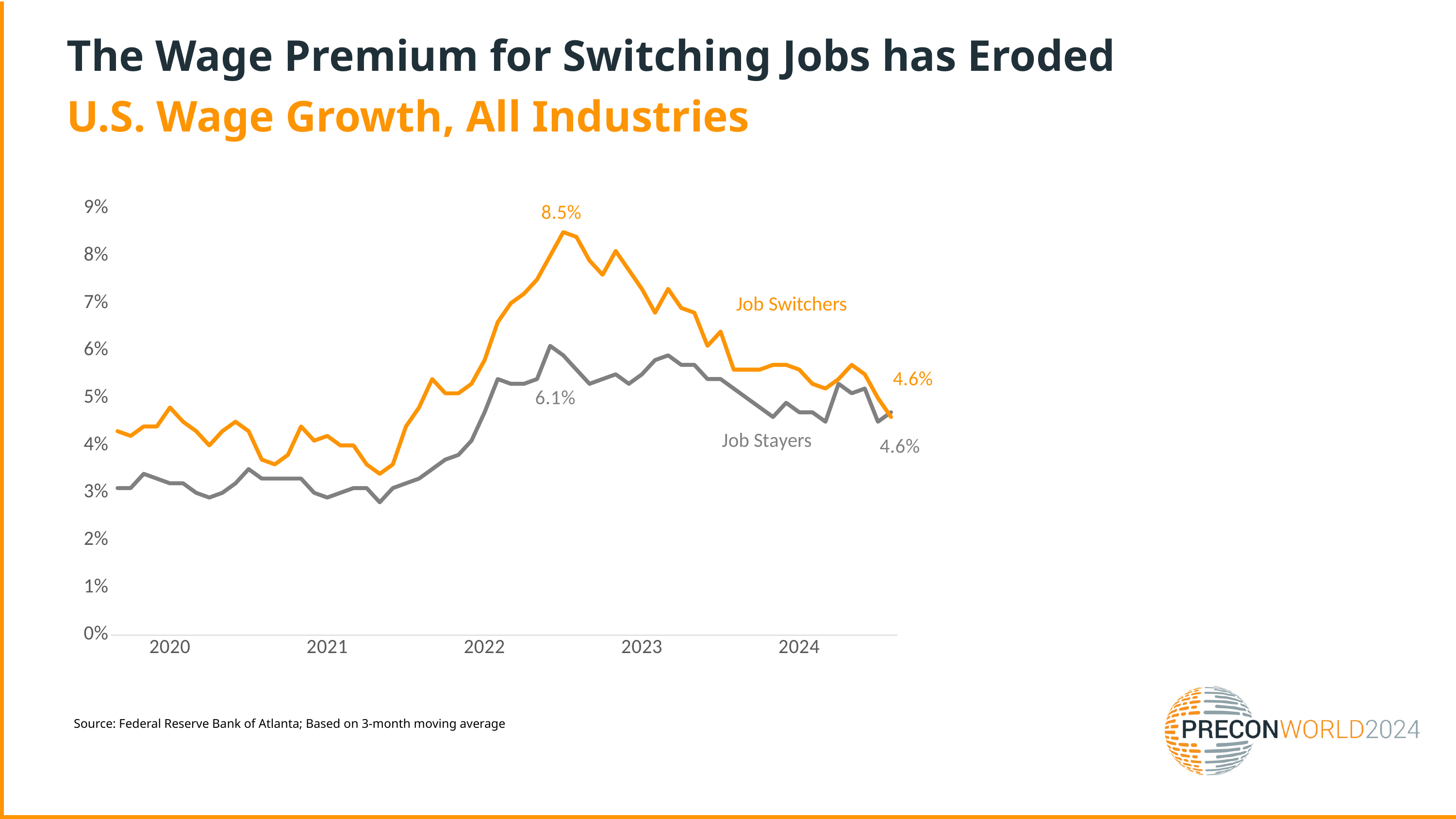
What kind of chart is shown on the slide? line chart How many data series are plotted on the chart? 2 What is the most recent labeled value for Job Stayers? 4.6% What is the labeled peak value for Job Stayers? 6.1% What is the labeled peak value for Job Switchers? 8.5% What is the title of the chart? U.S. Wage Growth, All Industries What is the difference between the labeled peak for Job Switchers and the labeled peak for Job Stayers? 2.4 percentage points Does the Job Switchers line rise or fall from its 2022 peak to 2024? fall Is the value for Job Stayers at the start of 2020 greater or less than 4%? less What is the most recent labeled value for Job Switchers? 4.6% Which series reached the higher peak, Job Switchers or Job Stayers? Job Switchers How many year labels are shown on the x axis? 5